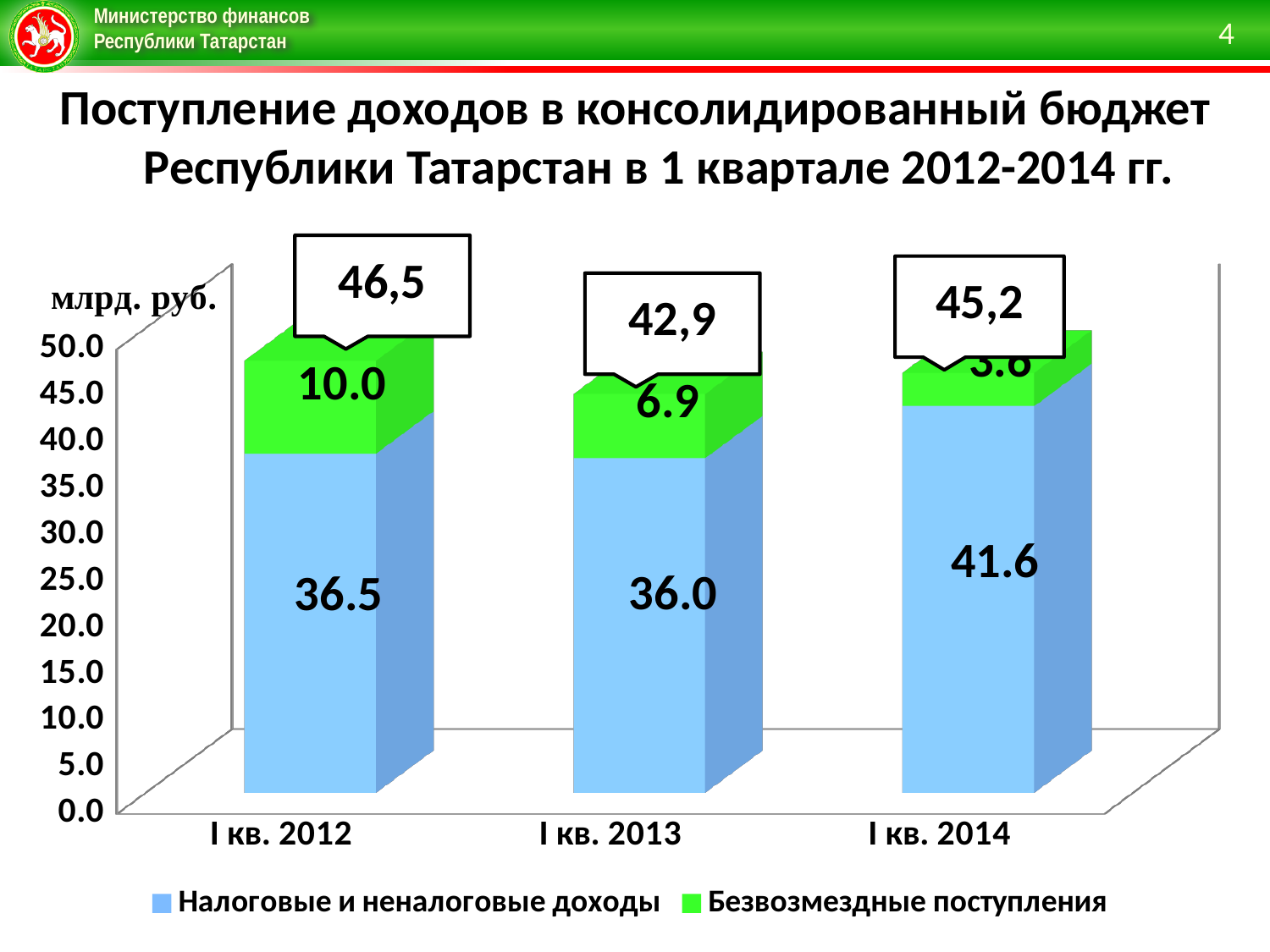
How many series does the legend list? 2 What is the value of Налоговые и неналоговые доходы for I кв. 2012? 36.5 What type of chart is shown on the slide? stacked bar chart Which series is shown in green in the legend? Безвозмездные поступления How many categories are shown on the x axis? 3 What is the total shown above the bar for I кв. 2014? 45,2 What is the total shown above the bar for I кв. 2012? 46,5 What is the difference between Безвозмездные поступления in I кв. 2012 and I кв. 2013? 3.1 Which quarter has the highest value of Налоговые и неналоговые доходы? I кв. 2014 What is the value of Безвозмездные поступления for I кв. 2013? 6.9 Which quarter has the lowest total shown in the callouts? I кв. 2013 What is the value of Налоговые и неналоговые доходы for I кв. 2014? 41.6